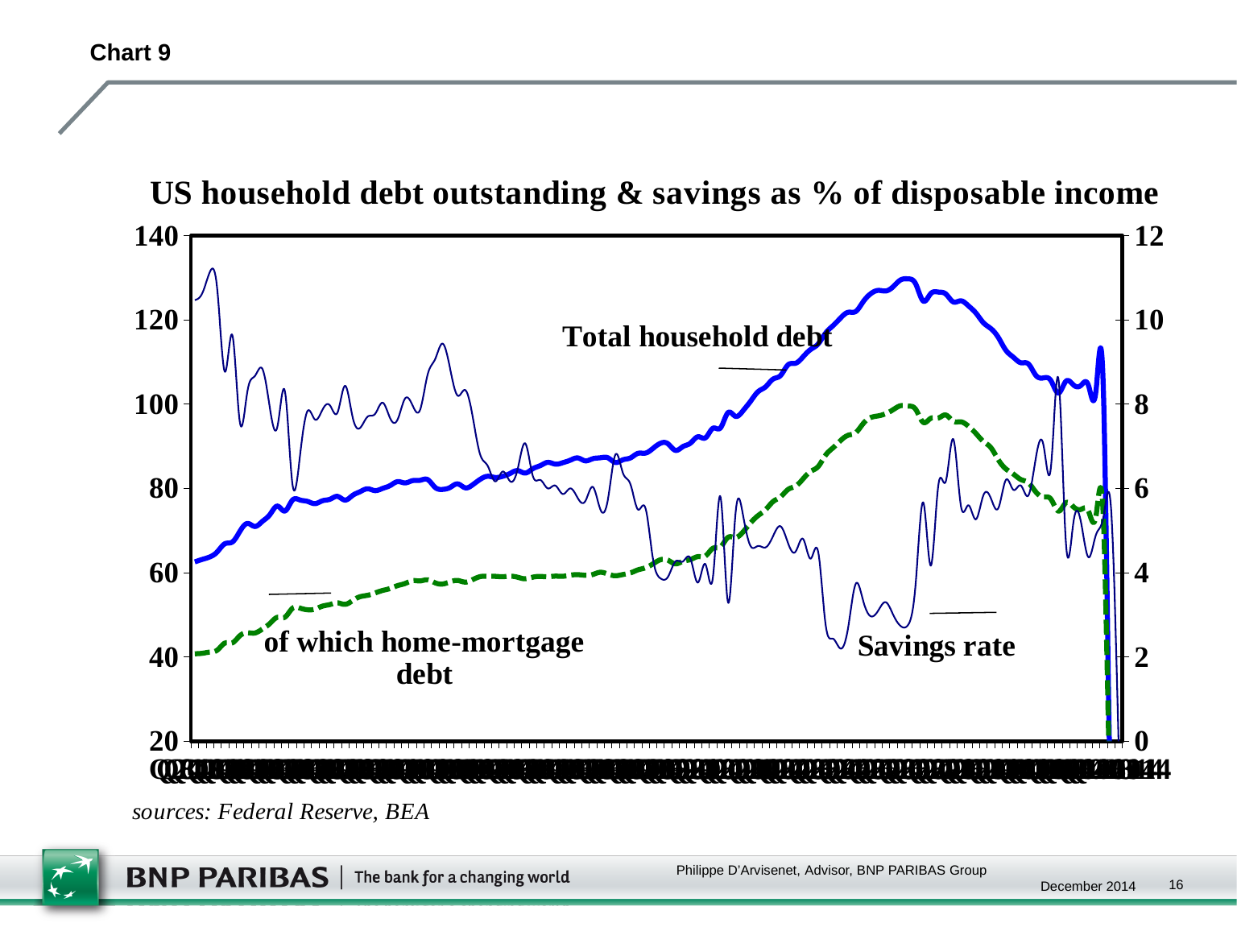
Is the value of Total household debt at the start of the series greater or less than 80 on the left axis? less Which is larger throughout the chart, Total household debt or home-mortgage debt? Total household debt Which series is plotted with the dashed green line? of which home-mortgage debt Is the lowest value of the Savings rate greater or less than 4 on the right axis? less Does the Savings rate generally rise or fall from the left of the chart to the right? fall Is the Savings rate at the start of the series greater or less than 8 on the right axis? greater What kind of chart is shown on the slide? line chart What is the title of the chart? US household debt outstanding & savings as % of disposable income What sources are cited below the chart? Federal Reserve, BEA How many data series are plotted on the chart? 3 Which series is plotted with the thick solid blue line? Total household debt